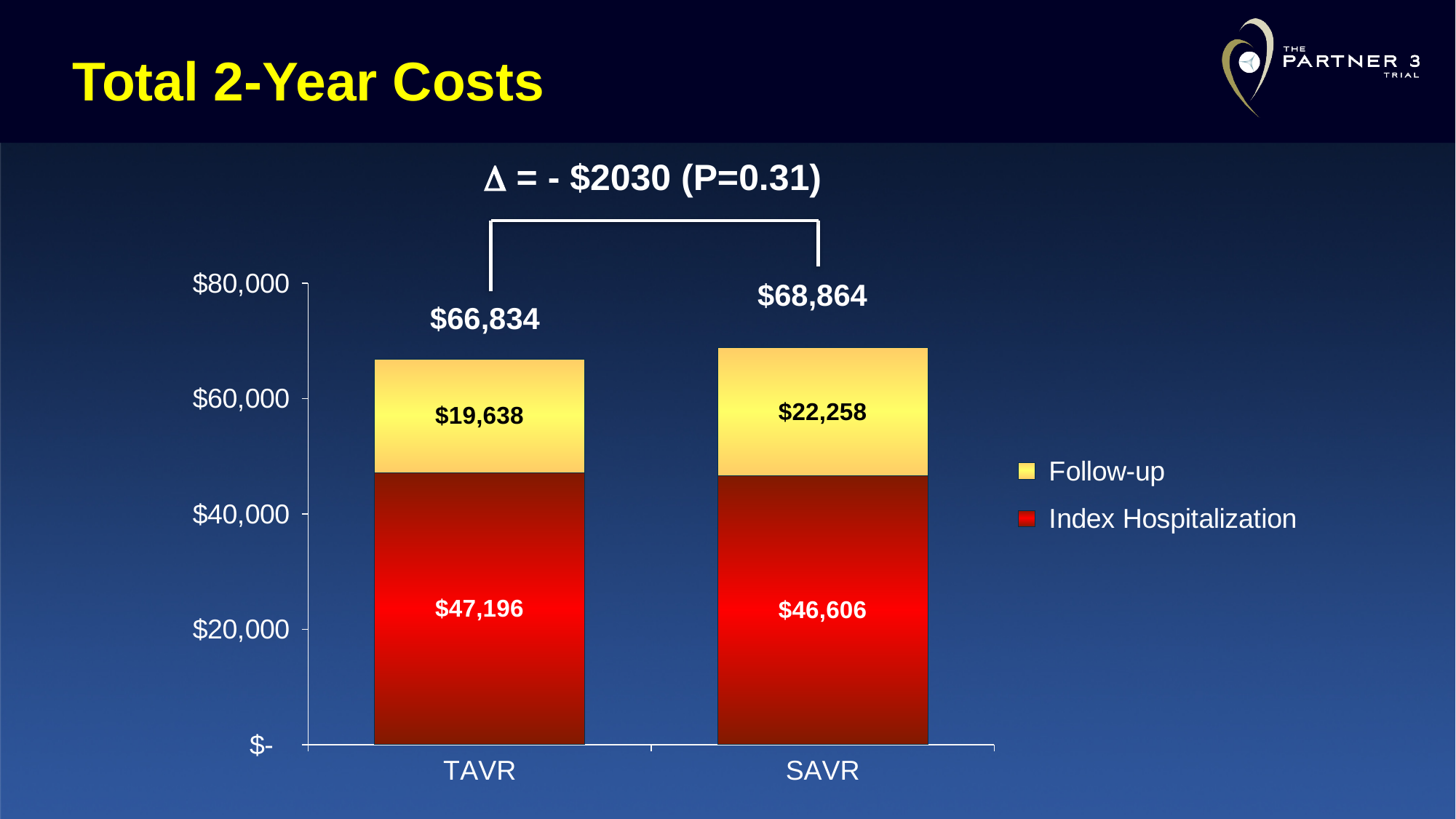
What is the difference in Index Hospitalization cost between TAVR and SAVR? $590 What is the Follow-up cost for SAVR? $22,258 What is the Follow-up cost for TAVR? $19,638 What is the Index Hospitalization cost for TAVR? $47,196 How many series does the legend list? 2 What is the total 2-year cost for the TAVR bar? $66,834 What kind of chart is shown on the slide? Stacked bar chart What is the Index Hospitalization cost for SAVR? $46,606 What is the total 2-year cost for the SAVR bar? $68,864 What is the difference in Follow-up cost between SAVR and TAVR? $2,620 Which group has the higher Follow-up cost, TAVR or SAVR? SAVR What is the difference in total cost between TAVR and SAVR shown above the chart? - $2030 (P=0.31)